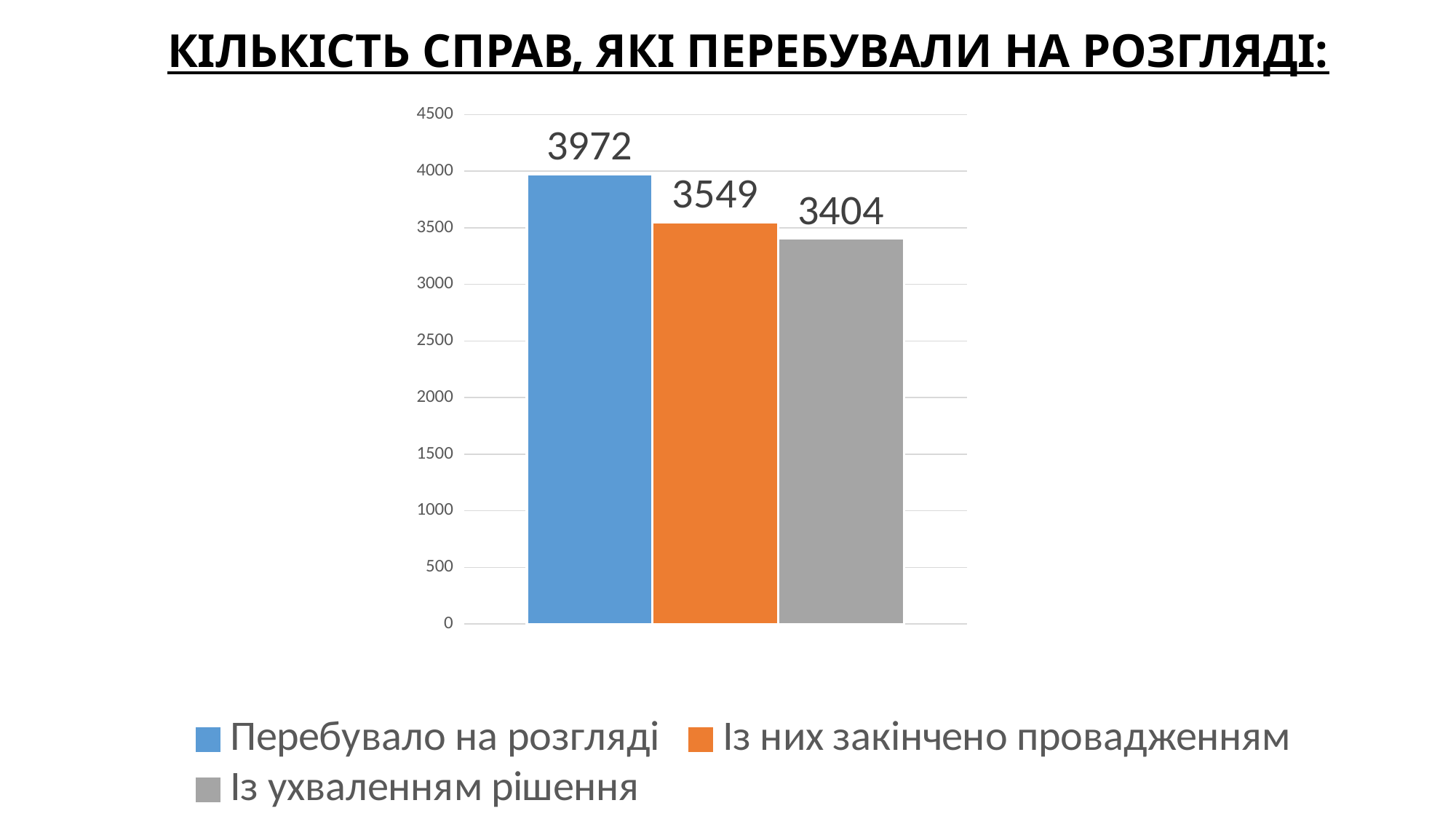
How many series does the legend list? 3 What is the title of the chart? КІЛЬКІСТЬ СПРАВ, ЯКІ ПЕРЕБУВАЛИ НА РОЗГЛЯДІ: What is the value for "Із них закінчено провадженням"? 3549 What is the value for "Із ухваленням рішення"? 3404 Is the value for "Перебувало на розгляді" greater or less than 3500? greater Which series has the highest value? Перебувало на розгляді Which is larger: "Із них закінчено провадженням" or "Із ухваленням рішення"? Із них закінчено провадженням What is the difference between "Із них закінчено провадженням" and "Із ухваленням рішення"? 145 What kind of chart is shown on the slide? bar chart What is the value for "Перебувало на розгляді"? 3972 What is the difference between "Перебувало на розгляді" and "Із них закінчено провадженням"? 423 Which series has the lowest value? Із ухваленням рішення